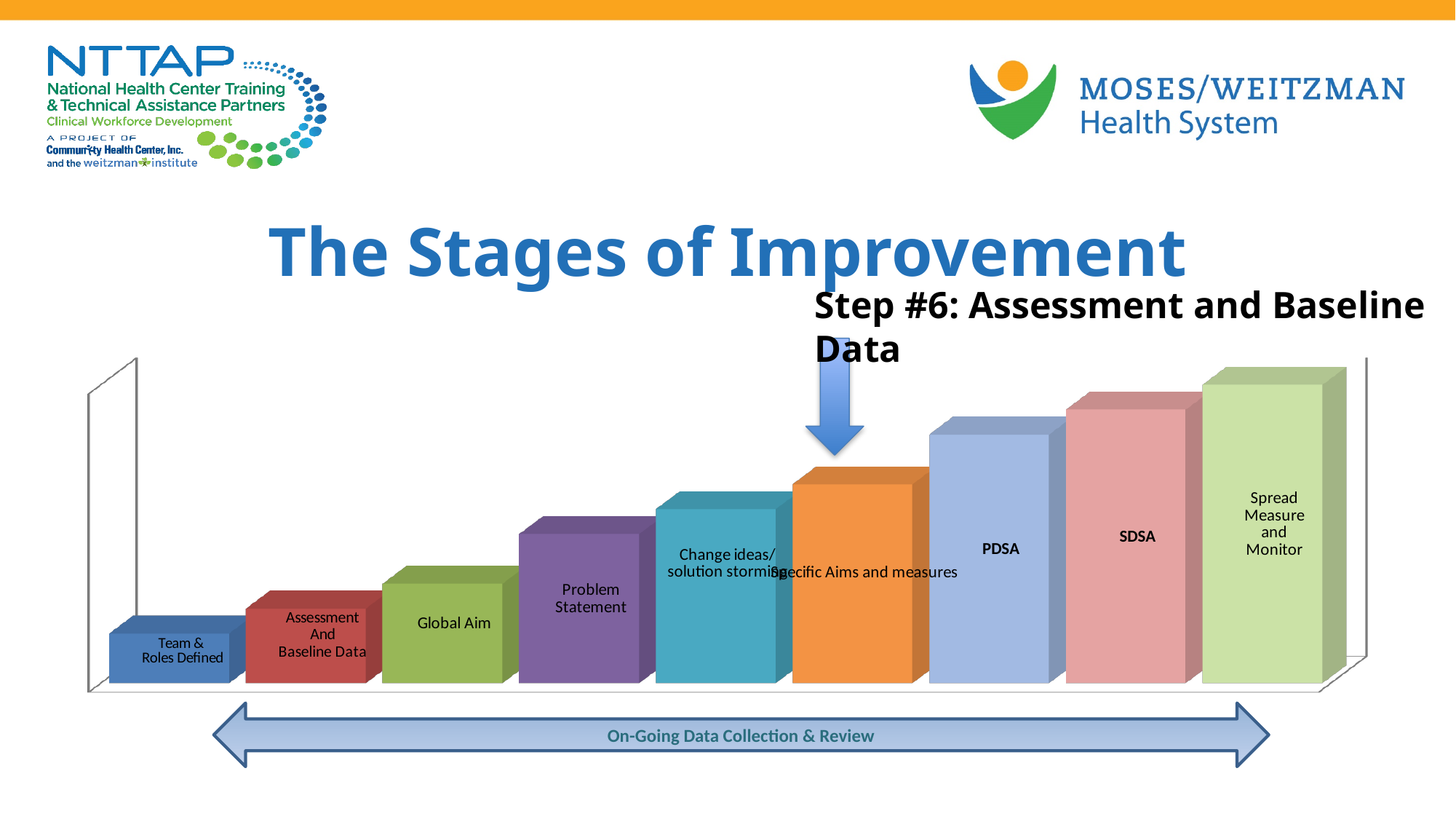
What text is written on the double-headed arrow below the bars? On-Going Data Collection & Review What is the label of the bar immediately to the right of Global Aim? Problem Statement Which bar is taller, Problem Statement or SDSA? SDSA What is the label of the first (leftmost) bar? Team & Roles Defined Which stage has the tallest bar? Spread Measure and Monitor How many bars (stages) are shown in the chart? 9 What is the title of the chart? The Stages of Improvement What kind of chart is shown on the slide? bar chart Do the bars rise or fall from left to right across the chart? rise Which stage has the shortest bar? Team & Roles Defined Which bar is taller, PDSA or Global Aim? PDSA